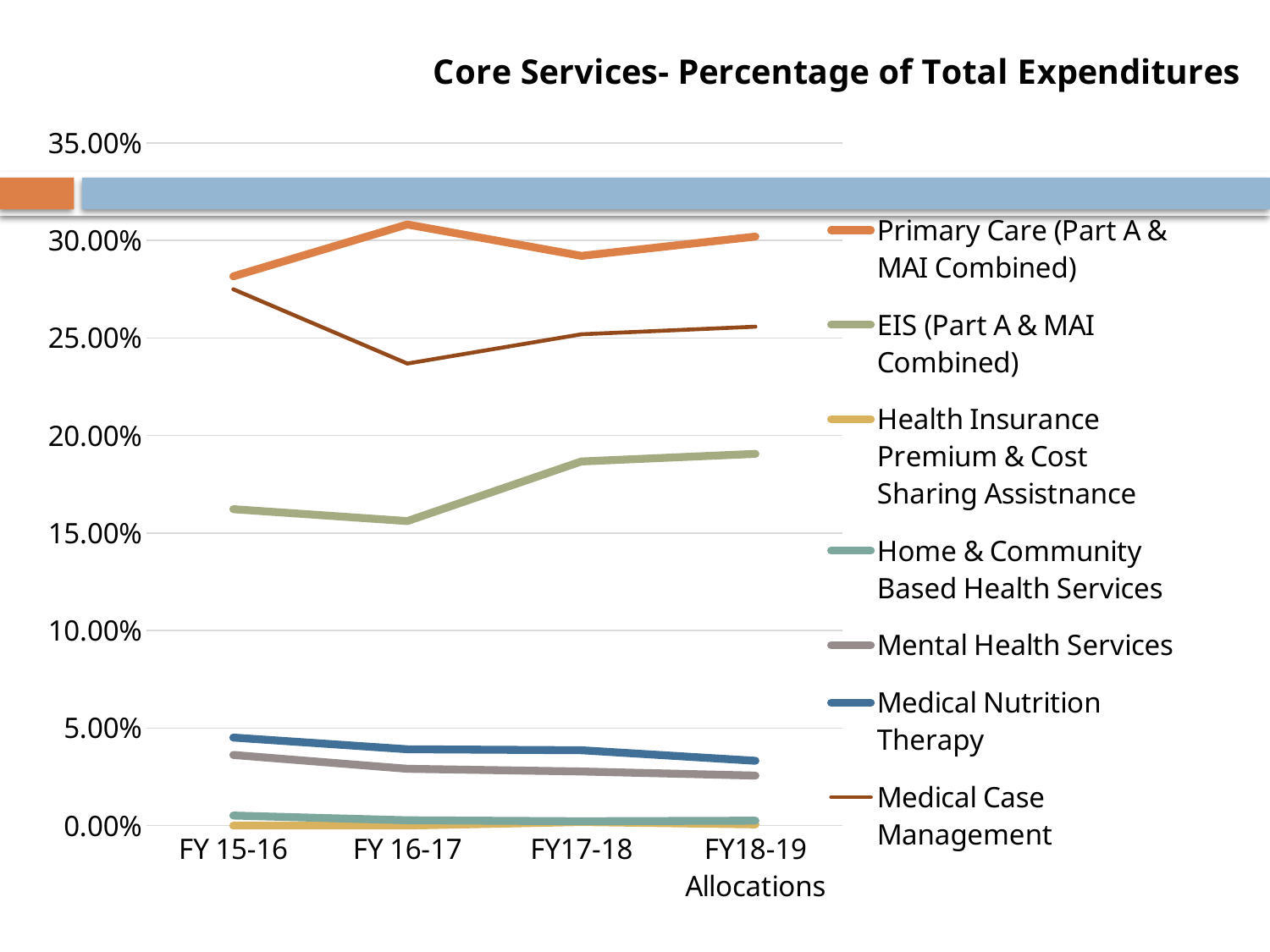
Is the value for Medical Nutrition Therapy at FY 15-16 greater or less than 5.00%? less What is the title of the chart? Core Services- Percentage of Total Expenditures How many fiscal year categories are shown on the x axis? 4 Which is larger at FY17-18: EIS (Part A & MAI Combined) or Medical Case Management? Medical Case Management How many series does the legend list? 7 Is the value for Medical Case Management at FY 16-17 greater or less than 25.00%? less Which series has the highest value at FY18-19 Allocations? Primary Care (Part A & MAI Combined) Is the value for Primary Care (Part A & MAI Combined) at FY 16-17 greater or less than 30.00%? greater Does the EIS (Part A & MAI Combined) line rise or fall overall from FY 15-16 to FY18-19 Allocations? rise What kind of chart is shown on the slide? line chart Does the Medical Nutrition Therapy line rise or fall from FY 15-16 to FY18-19 Allocations? fall